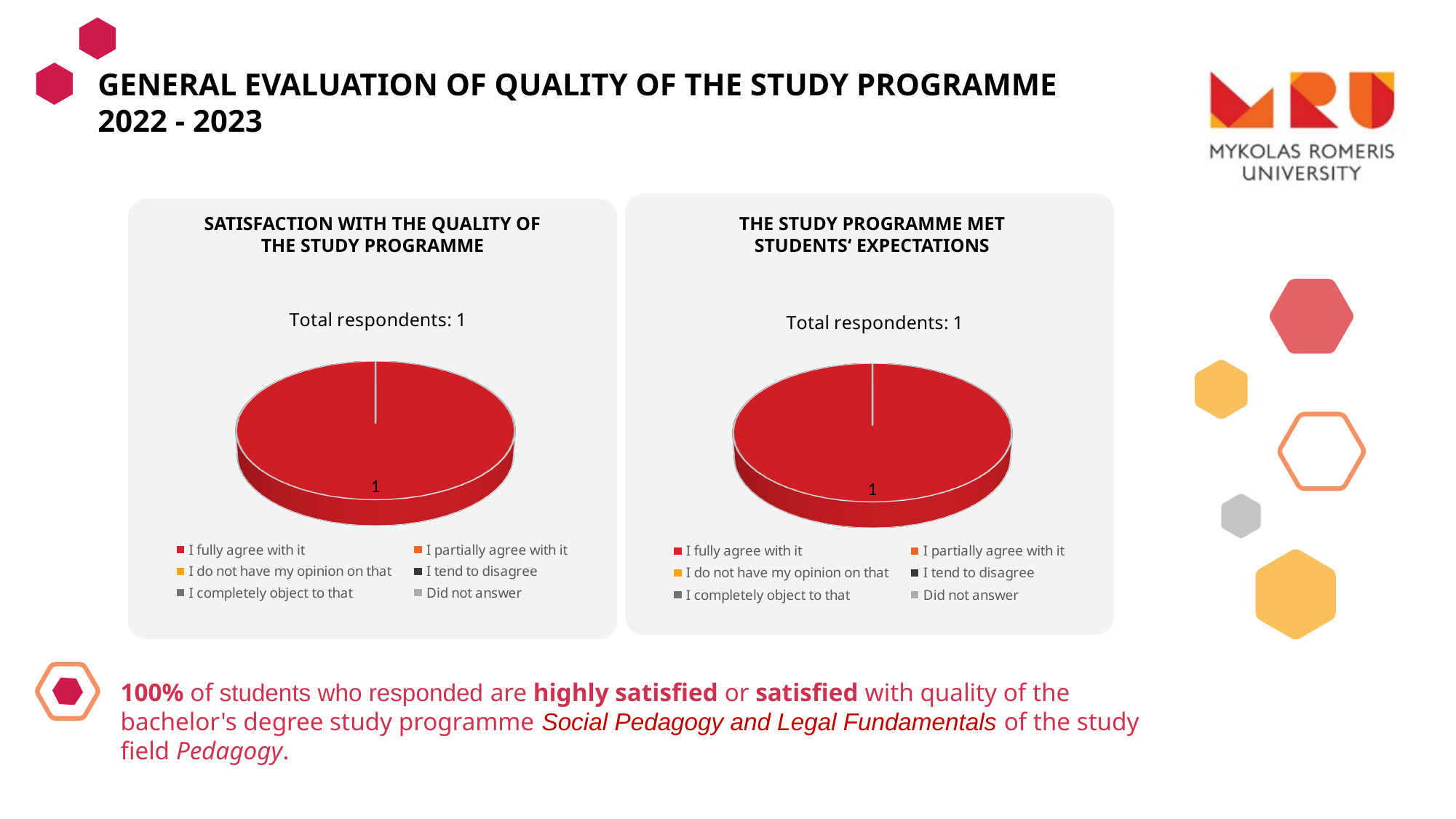
What type of chart is used in the 'Satisfaction with the quality of the study programme' panel? Pie chart How many entries does the legend list in the 'The study programme met students' expectations' chart? 6 In the 'Satisfaction with the quality of the study programme' chart, which legend category does the only visible slice belong to? I fully agree with it In the 'Satisfaction with the quality of the study programme' chart, what share of the pie does the 'I fully agree with it' slice take? 100% In the 'Satisfaction with the quality of the study programme' chart, what value is shown on the red slice? 1 In the 'The study programme met students' expectations' chart, which legend category does the only visible slice belong to? I fully agree with it What colour represents 'I do not have my opinion on that' in the legend of the 'The study programme met students' expectations' chart? Yellow How many pie charts are shown on the slide? 2 In the 'The study programme met students' expectations' chart, what value is shown on the red slice? 1 What is the total number of respondents shown for the 'Satisfaction with the quality of the study programme' chart? 1 What is the total number of respondents shown for the 'The study programme met students' expectations' chart? 1 How many entries does the legend list in the 'Satisfaction with the quality of the study programme' chart? 6